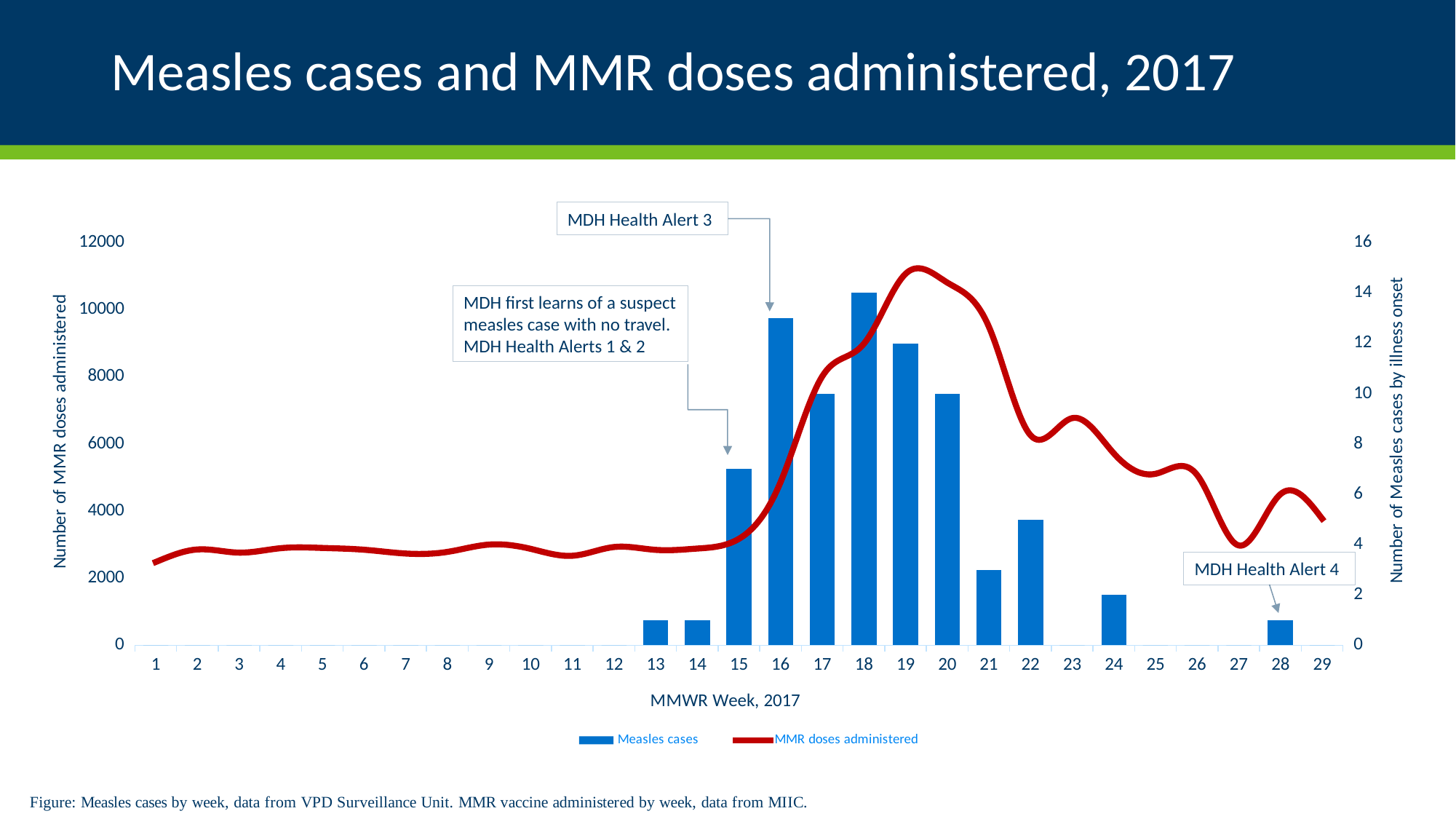
In which MMWR week is the number of measles cases highest? 18 What kind of chart is shown on the slide? Combination bar and line chart How many measles cases are shown for MMWR week 19? 12 Which series is drawn as the red line? MMR doses administered Is the number of MMR doses administered in week 5 greater or less than 4000? less Is the number of measles cases in week 16 greater or less than 12? greater How many measles cases are shown for MMWR week 17? 10 Which week has more measles cases, week 18 or week 20? Week 18 How many series does the legend list? 2 Is the number of MMR doses administered in week 19 greater or less than 10000? greater How many MMWR weeks are shown on the x axis? 29 Do MMR doses administered rise or fall from week 15 to week 19? Rise